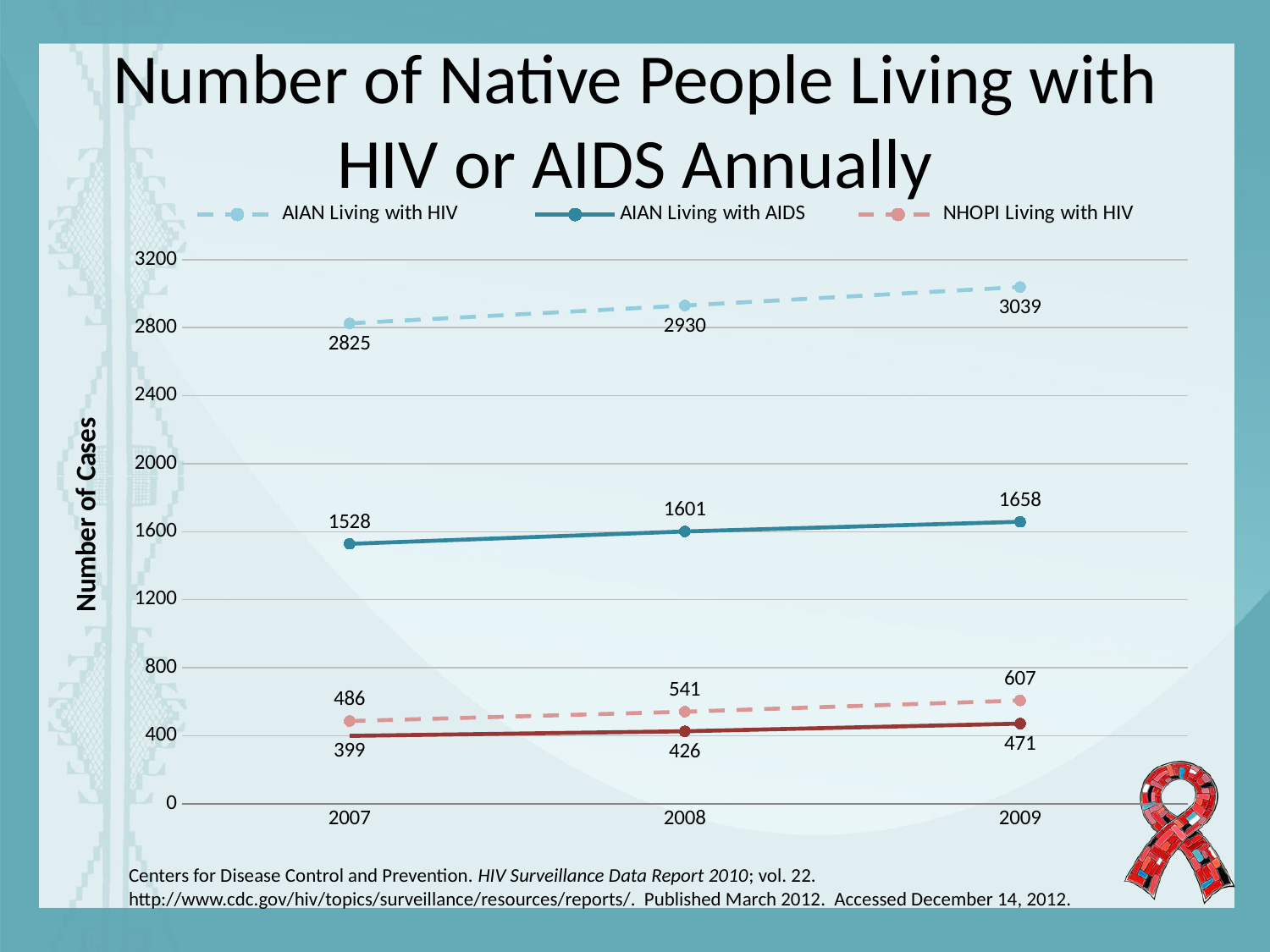
What is the difference between the AIAN Living with HIV values in 2009 and 2007? 214 What is the value for NHOPI Living with HIV in 2008? 541 In which year is the AIAN Living with HIV series highest? 2009 Is the value for AIAN Living with HIV in 2007 greater or less than 2400? greater What is the difference between AIAN Living with AIDS in 2008 and 2007? 73 Does the AIAN Living with AIDS series rise or fall from 2007 to 2009? rise How many series does the legend list? 3 In which year is the NHOPI Living with HIV series lowest? 2007 What is the value for AIAN Living with AIDS in 2007? 1528 How many years are shown on the x axis? 3 Which is larger in 2008: AIAN Living with AIDS or NHOPI Living with HIV? AIAN Living with AIDS What is the value for AIAN Living with HIV in 2009? 3039